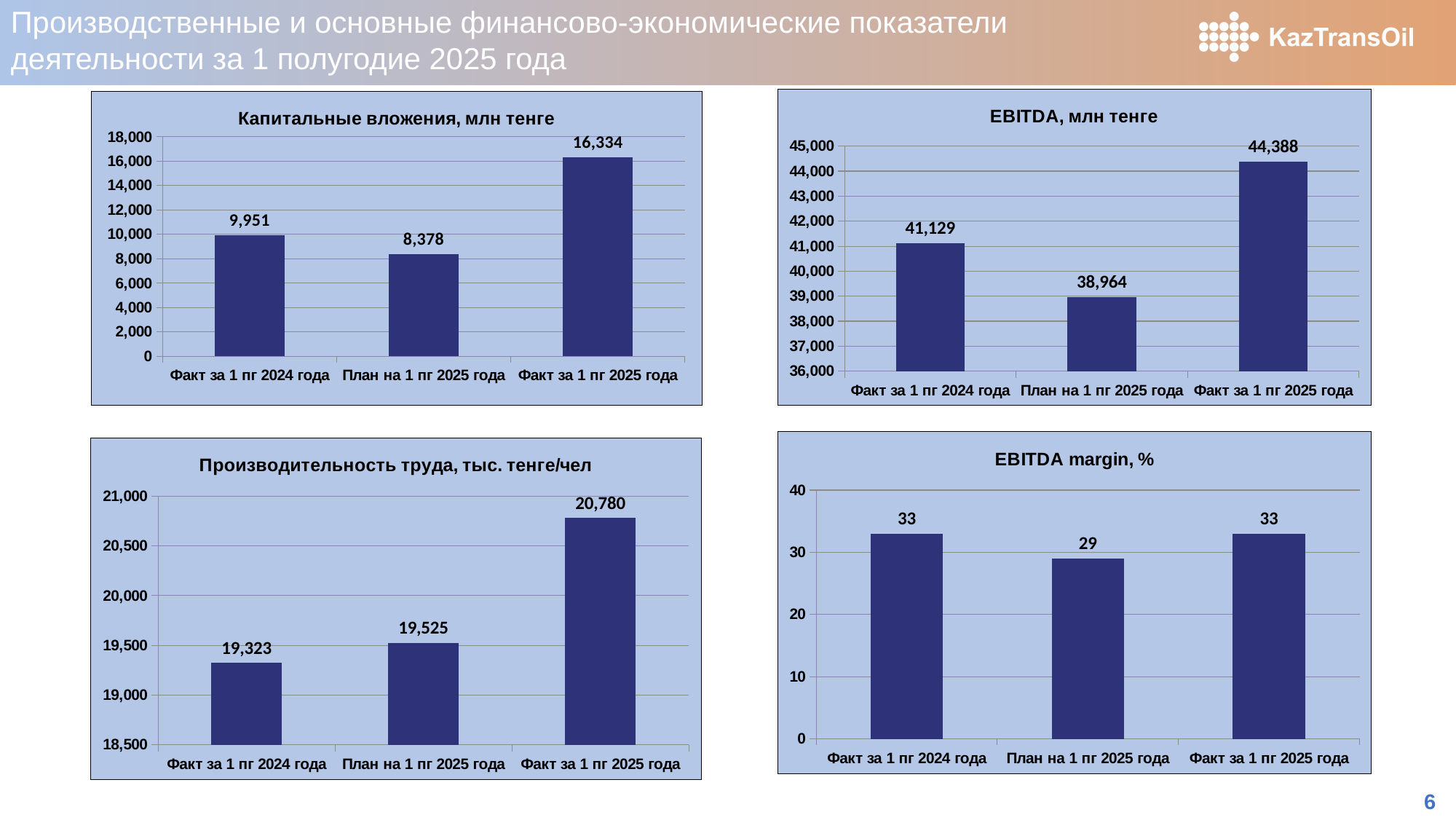
In the chart titled 'Производительность труда, тыс. тенге/чел', which is larger: 'План на 1 пг 2025 года' or 'Факт за 1 пг 2024 года'? План на 1 пг 2025 года In the chart titled 'Капитальные вложения, млн тенге', what is the difference between 'Факт за 1 пг 2025 года' and 'Факт за 1 пг 2024 года'? 6,383 In the chart titled 'Капитальные вложения, млн тенге', which category has the lowest value? План на 1 пг 2025 года In the chart titled 'Капитальные вложения, млн тенге', what is the value for 'Факт за 1 пг 2025 года'? 16,334 In the chart titled 'EBITDA margin, %', what is the value for 'План на 1 пг 2025 года'? 29 In the chart titled 'EBITDA margin, %', how many categories are shown on the x axis? 3 In the chart titled 'Производительность труда, тыс. тенге/чел', do the values rise or fall from left to right along the x axis? rise In the chart titled 'EBITDA, млн тенге', what is the difference between 'Факт за 1 пг 2025 года' and 'План на 1 пг 2025 года'? 5,424 In the chart titled 'EBITDA, млн тенге', which category has the highest value? Факт за 1 пг 2025 года What kind of chart is the chart titled 'EBITDA margin, %'? bar chart In the chart titled 'Производительность труда, тыс. тенге/чел', what is the value for 'Факт за 1 пг 2024 года'? 19,323 In the chart titled 'EBITDA, млн тенге', what is the value for 'План на 1 пг 2025 года'? 38,964